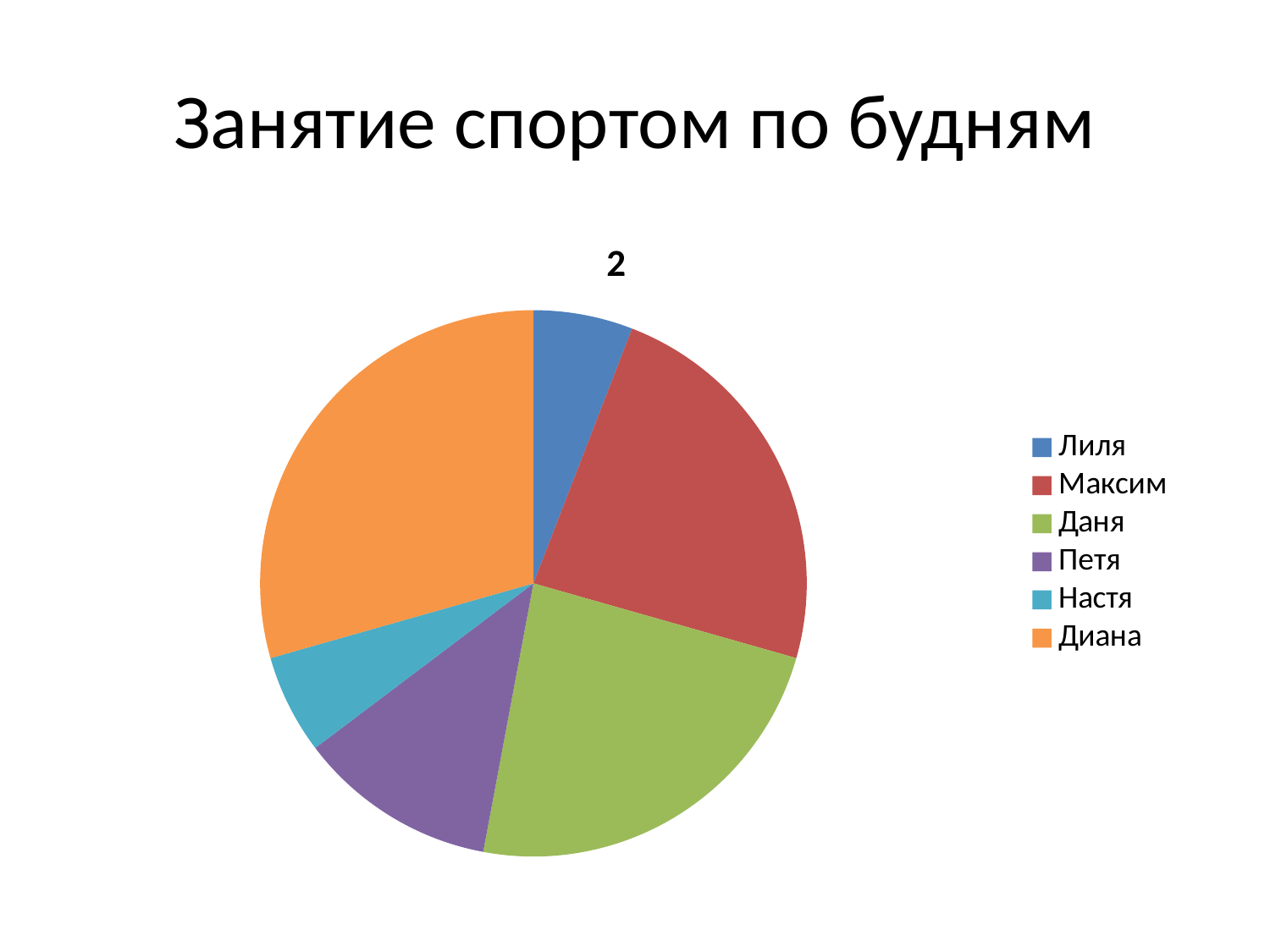
How many slices does the pie chart have? 6 Which category has the largest slice of the pie chart? Диана Which legend entry is shown in orange? Диана What kind of chart is shown on the slide? pie chart Which slice is larger, Петя or Настя? Петя What is the title shown above the pie chart? 2 Which slice is larger, Даня or Настя? Даня Which slice is larger, Диана or Петя? Диана